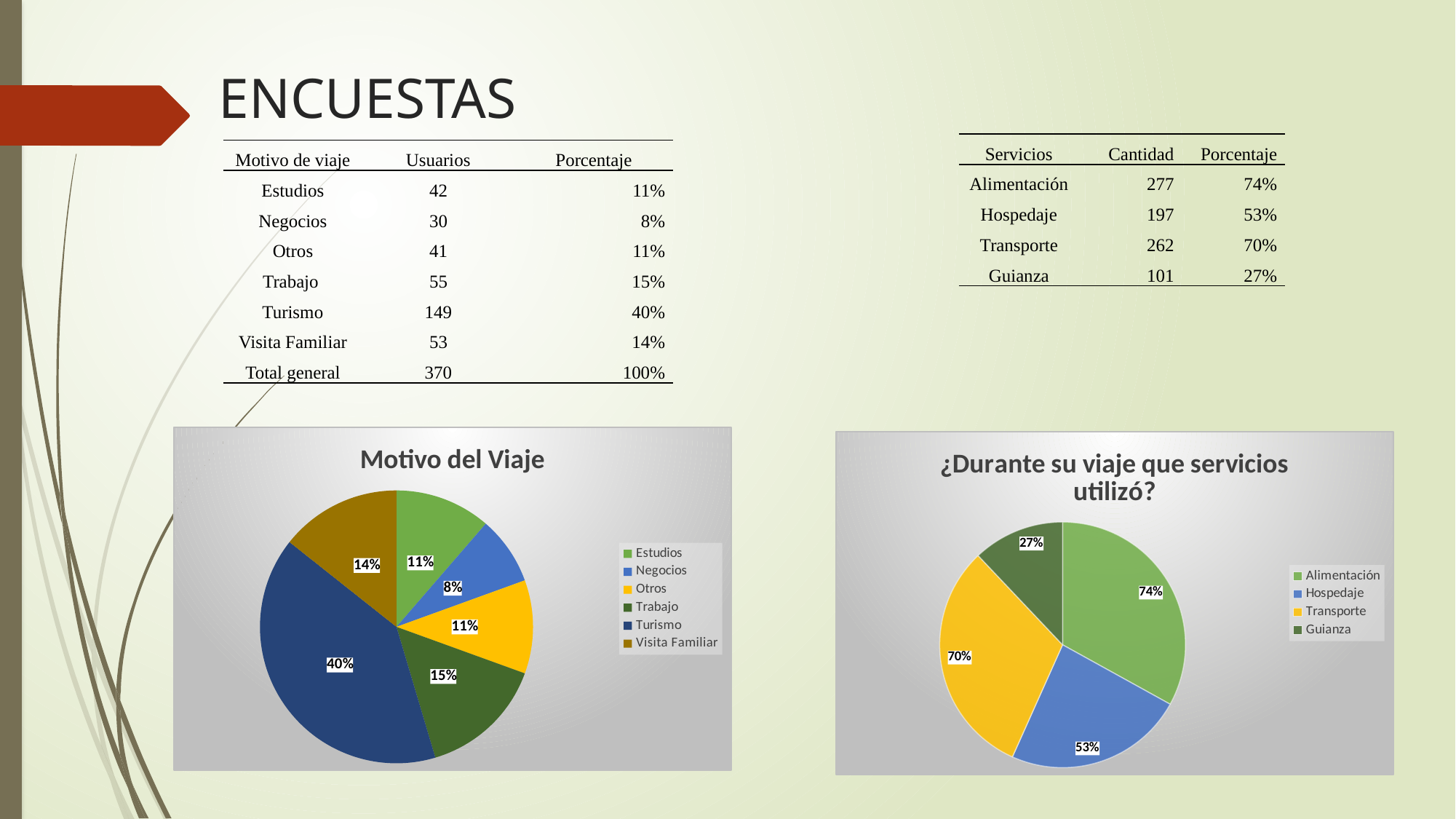
In the 'Motivo del Viaje' chart, how many categories does the legend list? 6 In the 'Motivo del Viaje' chart, what percentage is shown for Negocios? 8% In the '¿Durante su viaje que servicios utilizó?' chart, which service has the highest percentage? Alimentación What kind of chart is 'Motivo del Viaje'? Pie chart In the '¿Durante su viaje que servicios utilizó?' chart, which service has the lowest percentage? Guianza In the 'Motivo del Viaje' chart, what percentage is shown for Turismo? 40% In the 'Motivo del Viaje' chart, what is the difference between the Turismo and Trabajo percentages? 25% In the 'Motivo del Viaje' chart, which category has the smallest slice? Negocios In the '¿Durante su viaje que servicios utilizó?' chart, what percentage is shown for Hospedaje? 53% In the '¿Durante su viaje que servicios utilizó?' chart, which is larger, Transporte or Hospedaje? Transporte In the 'Motivo del Viaje' chart, which category has the largest slice? Turismo In the '¿Durante su viaje que servicios utilizó?' chart, what colour is the Transporte slice? Yellow